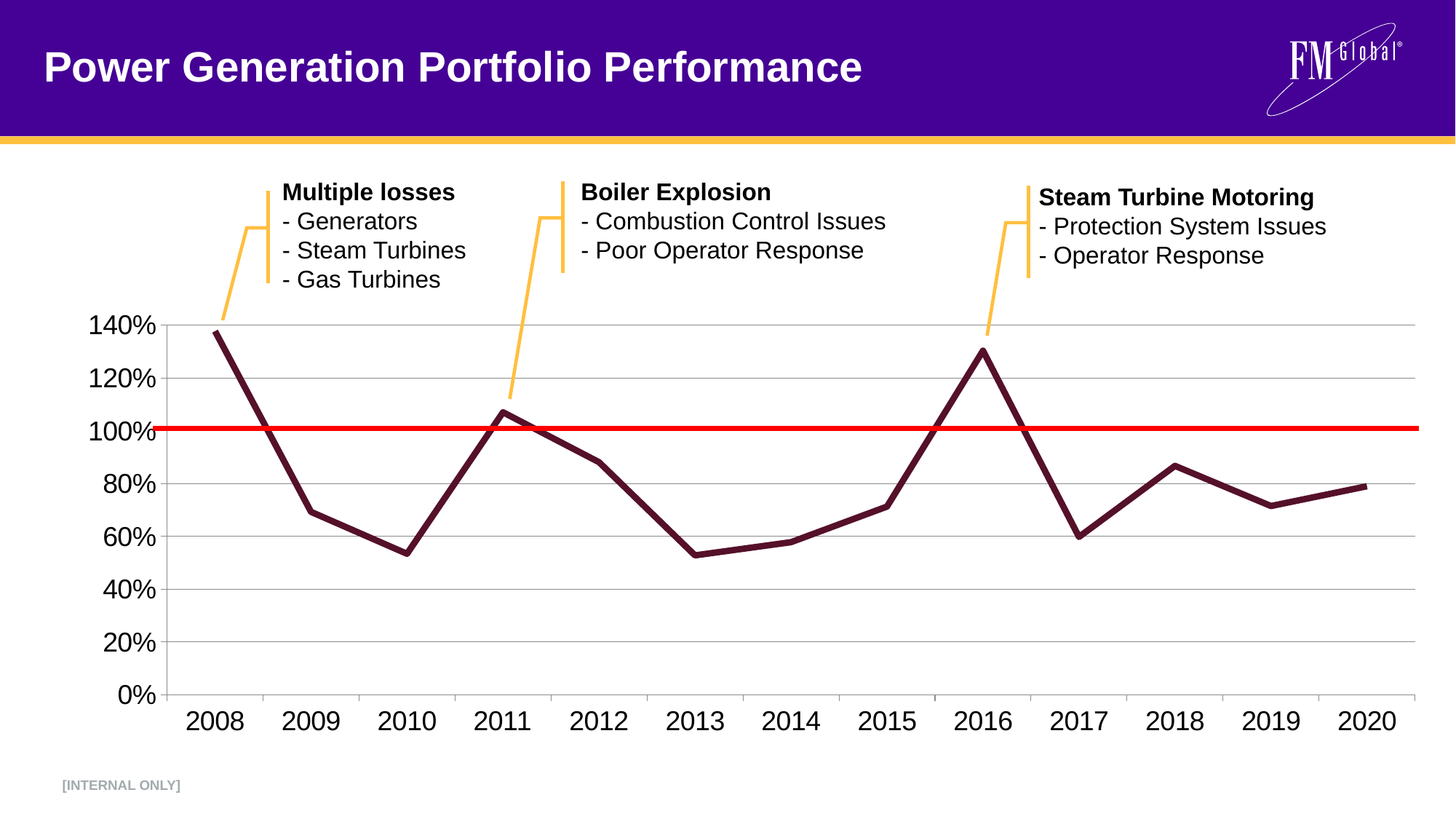
Which is larger, the value for 2016 or the value for 2017? 2016 What event is annotated at the 2011 peak? Boiler Explosion Is the value for 2011 greater or less than 100%? greater What kind of chart is shown on the slide? line chart Is the value for 2016 greater or less than 120%? greater Is the value for 2013 greater or less than 60%? less Does the value rise or fall from 2013 to 2016? rise Which year has the highest value on the chart? 2008 Does the value rise or fall from 2008 to 2010? fall How many years are plotted along the x axis? 13